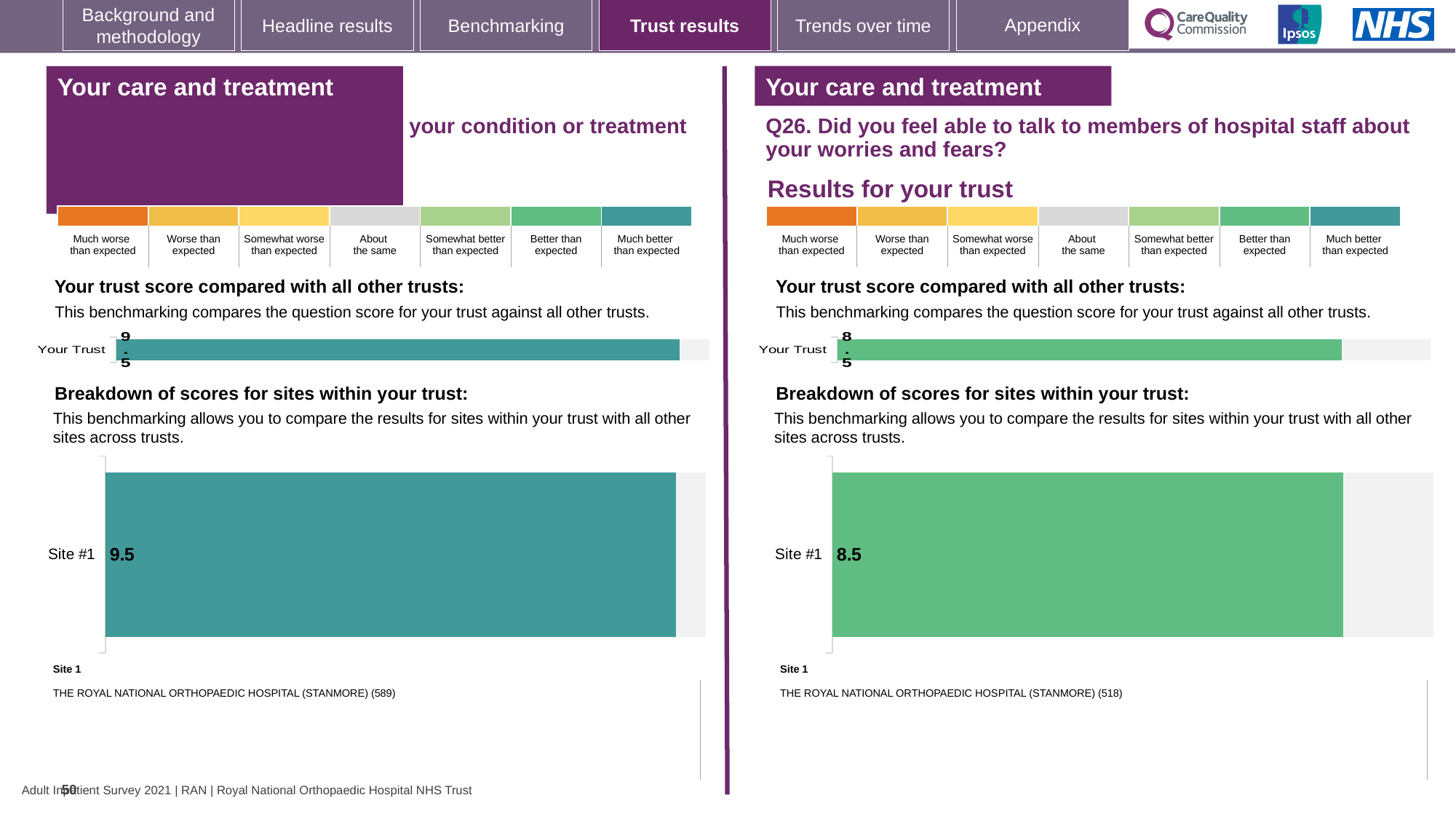
What kind of chart is used to show the Your Trust score on the left-hand side of the slide? Bar chart In the left-hand 'Breakdown of scores for sites within your trust' chart, what is the value for Site #1? 9.5 What kind of chart is used to show the Site #1 score on the right-hand side of the slide (Q26)? Bar chart How many sites are shown in the left-hand 'Breakdown of scores for sites within your trust' chart? 1 On the right-hand side of the slide (Q26), what is the score shown for Your Trust in the 'Your trust score compared with all other trusts' chart? 8.5 Which is larger: the Your Trust score on the left-hand side of the slide or the Your Trust score on the right-hand side (Q26)? Left-hand side (9.5) Which site name is listed as Site 1 beneath the right-hand breakdown chart for Q26? THE ROYAL NATIONAL ORTHOPAEDIC HOSPITAL (STANMORE) (518) How many sites are shown in the right-hand 'Breakdown of scores for sites within your trust' chart for Q26? 1 On the left-hand side of the slide, what is the score shown for Your Trust in the 'Your trust score compared with all other trusts' chart? 9.5 In the right-hand 'Breakdown of scores for sites within your trust' chart for Q26, what is the value for Site #1? 8.5 What colour is the Site #1 bar in the right-hand breakdown chart for Q26? Green What is the difference between the Site #1 score on the left-hand side of the slide and the Site #1 score on the right-hand side (Q26)? 1